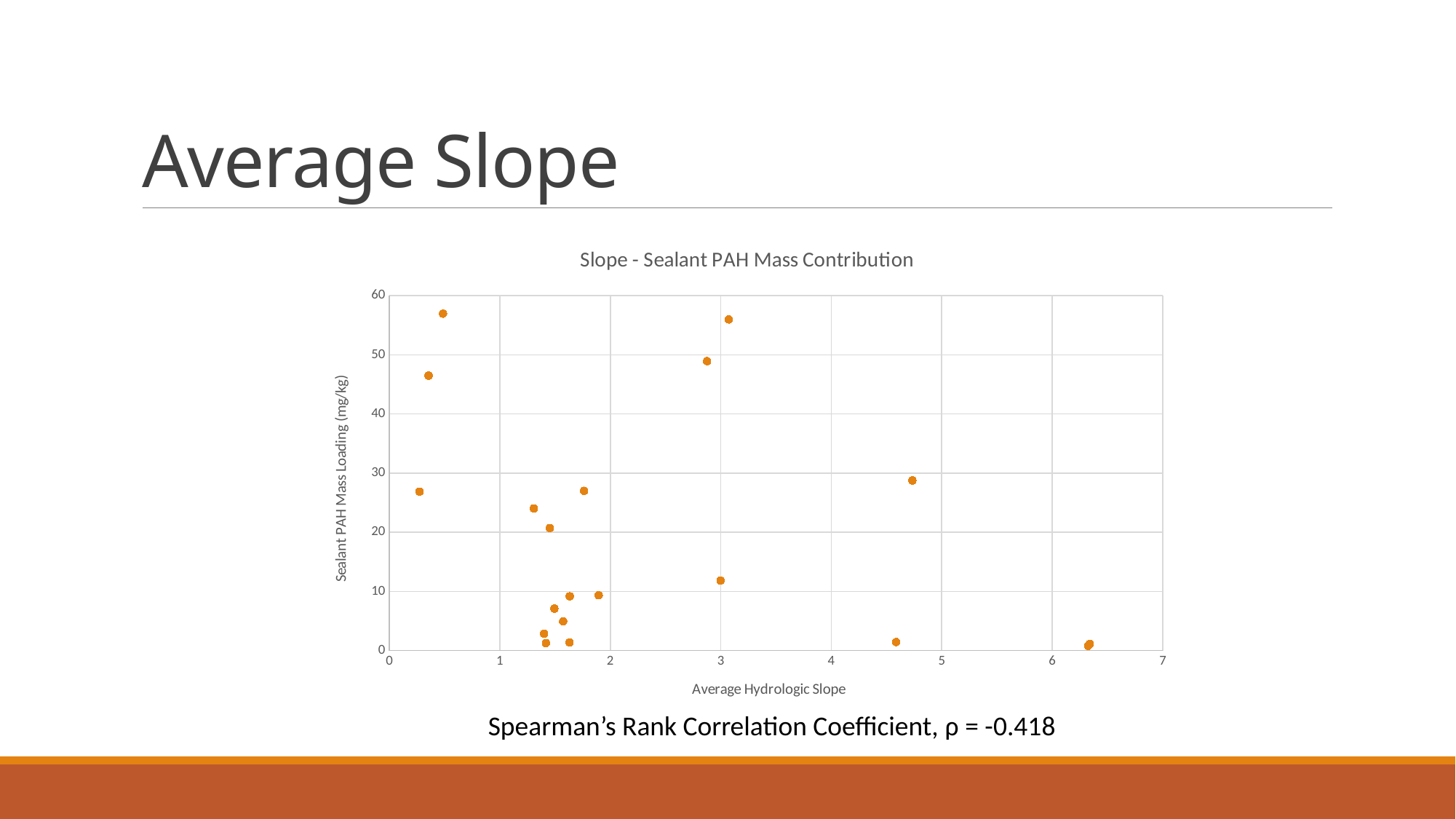
What is the highest tick value shown on the y axis? 60 What is the highest tick value shown on the x axis? 7 What kind of chart is shown on the slide? scatter plot How many points have a Sealant PAH Mass Loading greater than 40? 4 What is the label of the y axis of the chart? Sealant PAH Mass Loading (mg/kg) What is the title of the chart? Slope - Sealant PAH Mass Contribution Is the highest Sealant PAH Mass Loading value plotted greater or less than 50? greater Is the Sealant PAH Mass Loading of the point with the largest Average Hydrologic Slope greater or less than 10? less Is the Spearman's Rank Correlation Coefficient reported for this chart positive or negative? negative Is the Average Hydrologic Slope of the point with the lowest Sealant PAH Mass Loading greater or less than 6? greater How many points have an Average Hydrologic Slope between 4 and 5? 2